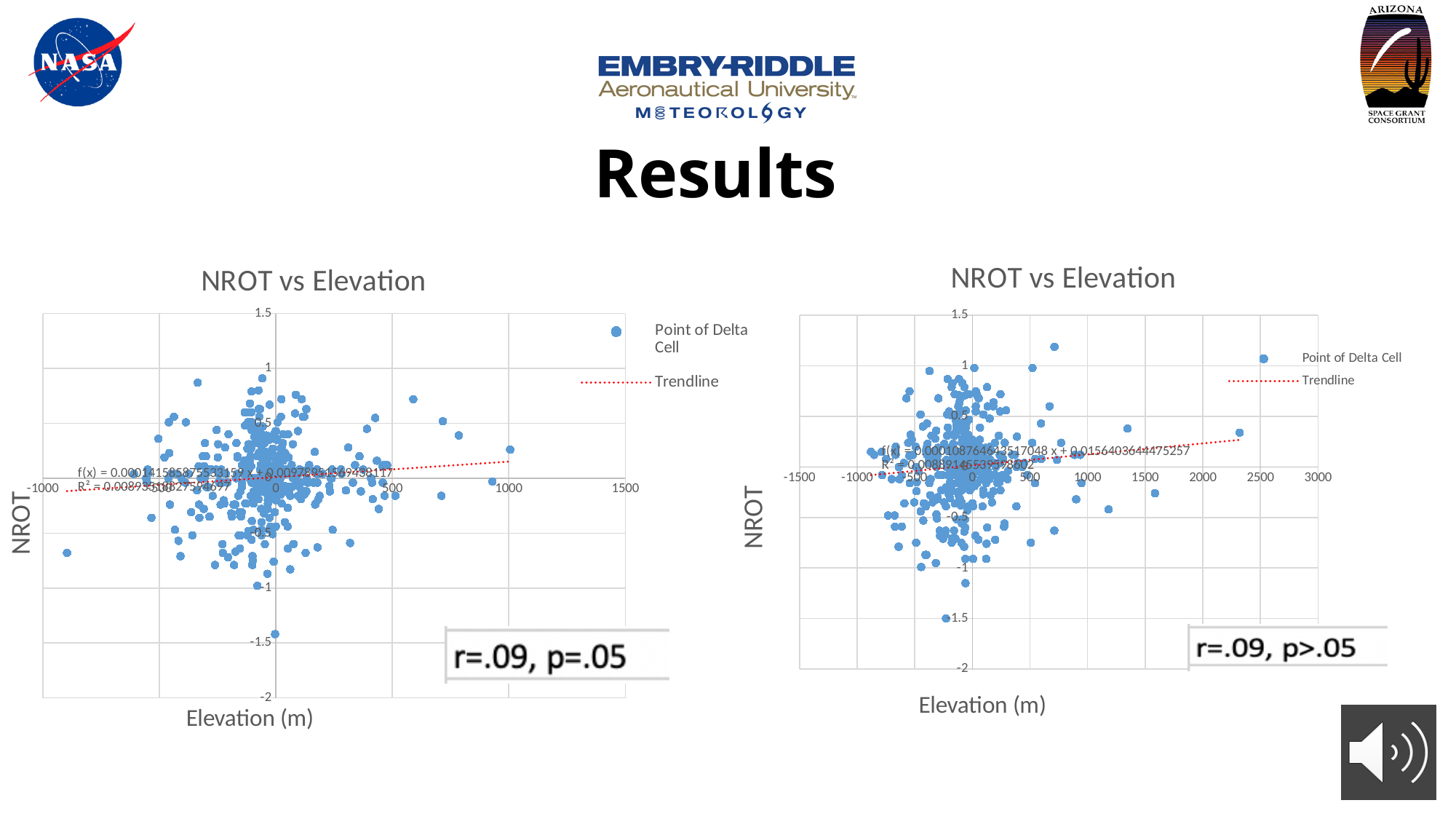
How many series does the legend of the right chart list? 2 In the left chart, does the trendline rise or fall as elevation increases? rise What kind of chart is the right chart titled "NROT vs Elevation"? scatter chart What is the x-axis title of the left chart? Elevation (m) What is the y-axis title of the right chart? NROT What correlation and p-value are annotated on the right chart? r=.09, p>.05 In the right chart, does the trendline rise or fall as elevation increases? rise What is the lowest tick value shown on the y axis of the left chart? -2 What kind of chart is the left chart titled "NROT vs Elevation"? scatter chart How many series does the legend of the left chart list? 2 What is the highest tick value shown on the x axis of the left chart? 1500 What is the highest tick value shown on the x axis of the right chart? 3000